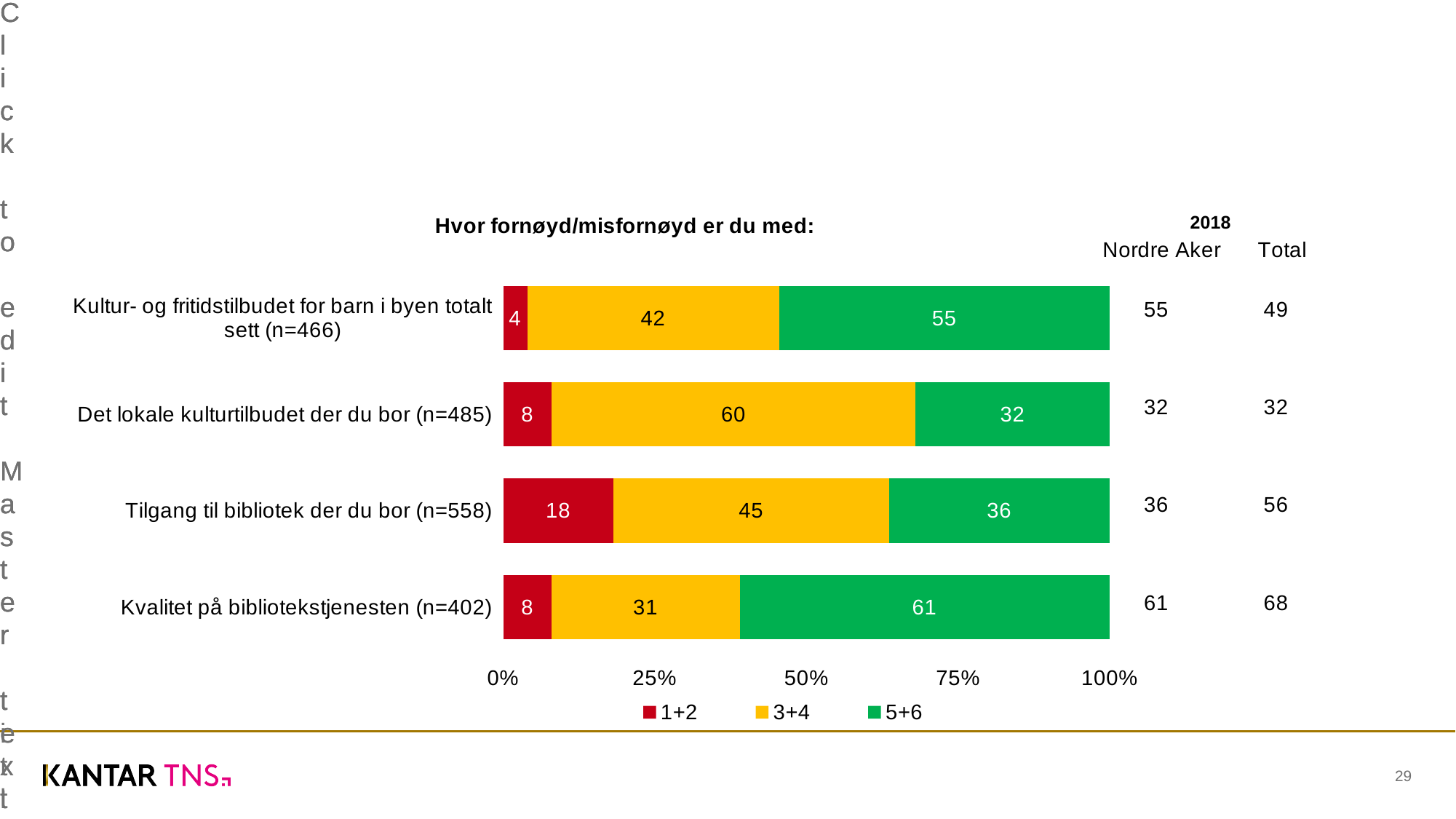
What is the value of the 3+4 segment for "Det lokale kulturtilbudet der du bor (n=485)"? 60 What kind of chart is shown on the slide? Stacked bar chart What is the total of the stacked bar for "Tilgang til bibliotek der du bor (n=558)"? 99 What is the difference between the 5+6 values for "Kvalitet på bibliotekstjenesten (n=402)" and "Det lokale kulturtilbudet der du bor (n=485)"? 29 What is the value of the 5+6 segment for "Kvalitet på bibliotekstjenesten (n=402)"? 61 What is the value of the 1+2 segment for "Tilgang til bibliotek der du bor (n=558)"? 18 How many categories are plotted in the chart? 4 Which is larger: the 3+4 value for "Tilgang til bibliotek der du bor (n=558)" or the 3+4 value for "Kultur- og fritidstilbudet for barn i byen totalt sett (n=466)"? Tilgang til bibliotek der du bor (n=558) Which category has the highest 5+6 value? Kvalitet på bibliotekstjenesten (n=402) Which category has the lowest 1+2 value? Kultur- og fritidstilbudet for barn i byen totalt sett (n=466) What is the title of the chart? Hvor fornøyd/misfornøyd er du med: How many series does the legend list? 3